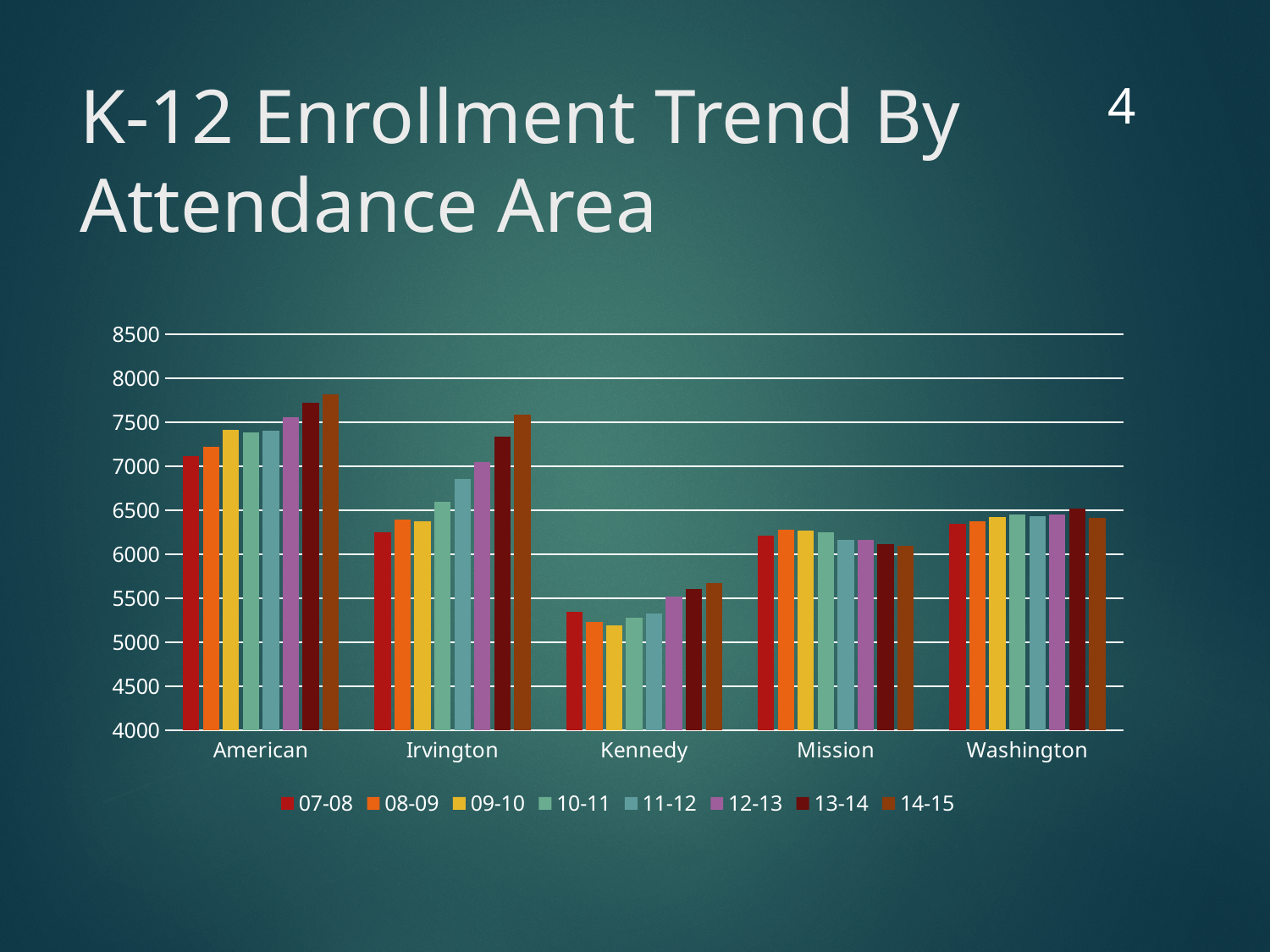
Which attendance area has the highest enrollment in 14-15? American Which attendance area has the lowest enrollment in 07-08? Kennedy Is the value for American in 14-15 greater or less than 7500? greater What type of chart is shown on the slide? Bar chart How many school years does the legend list? 8 What is the first series listed in the chart legend? 07-08 How many attendance areas are shown on the x axis of the chart? 5 Is the value for Kennedy in 09-10 greater or less than 5500? less What is the title of the slide containing the chart? K-12 Enrollment Trend By Attendance Area Which is larger, the 14-15 value for Irvington or the 14-15 value for Mission? Irvington Is the value for Mission in 14-15 greater or less than 6500? less Do the values for Irvington rise or fall from 07-08 to 14-15? rise